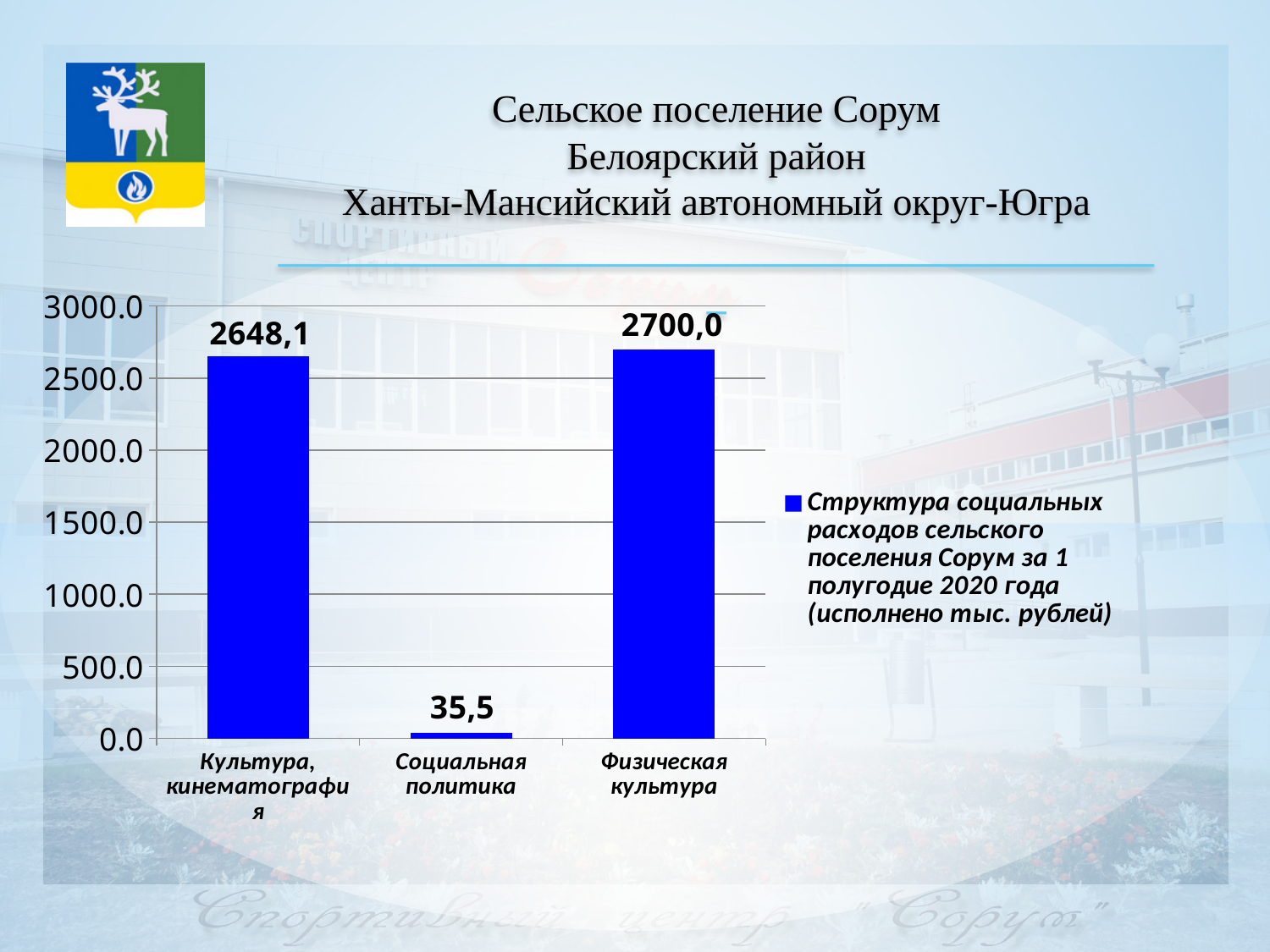
What is the value for Социальная политика? 35,5 What kind of chart is shown on the slide? bar chart How many categories are shown on the chart? 3 Which category has the lowest value? Социальная политика What is the difference between the values for Физическая культура and Культура, кинематография? 51,9 Is the value for Социальная политика greater or less than 500? less Which category has the highest value? Физическая культура What is the difference between the values for Культура, кинематография and Социальная политика? 2612,6 Which is larger, the value for Культура, кинематография or the value for Социальная политика? Культура, кинематография What is the value for Культура, кинематография? 2648,1 What is the value for Физическая культура? 2700,0 How many series does the legend list? 1